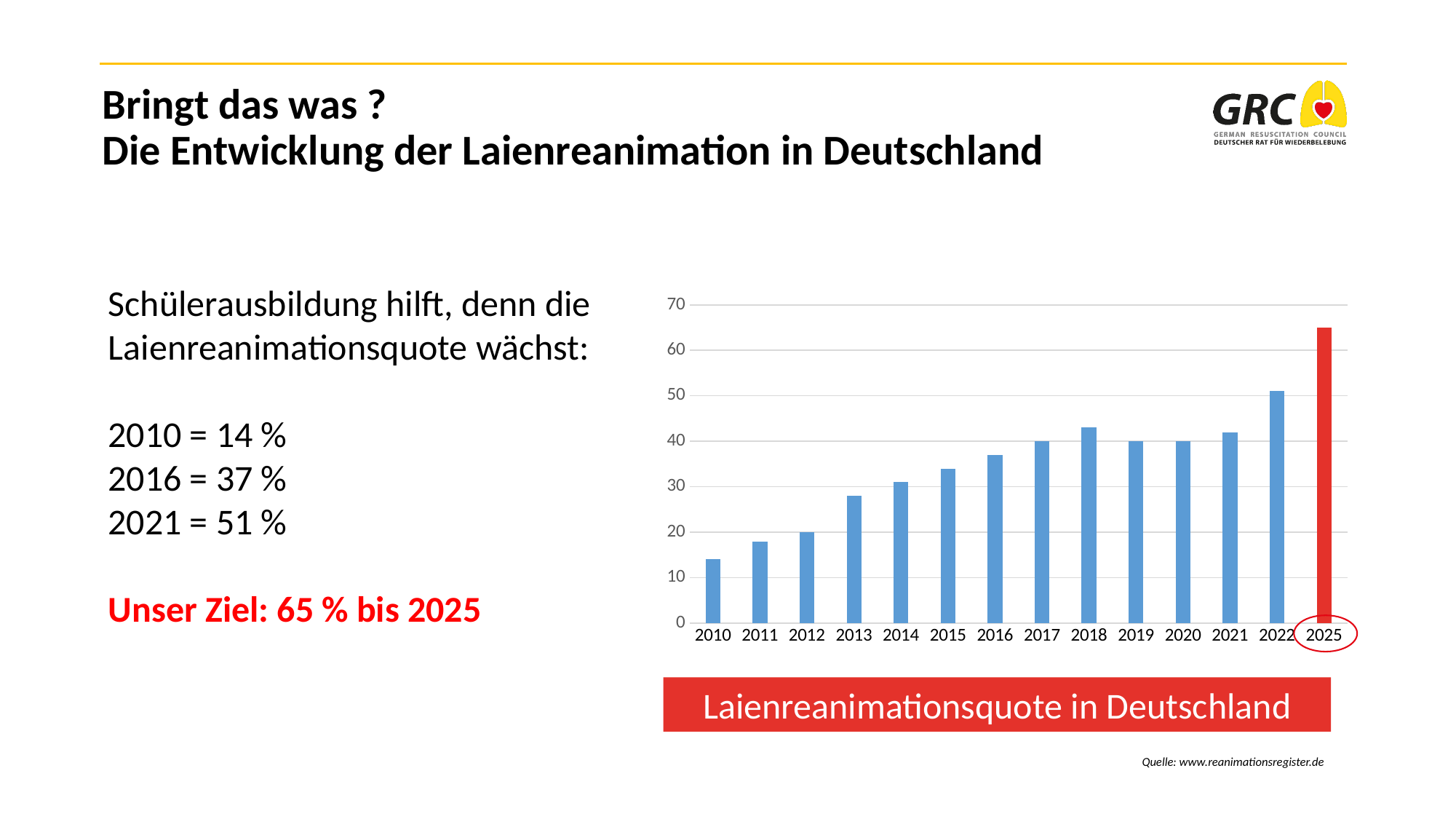
What is the target value shown for 2025? 65 % How many years are shown on the x axis of the chart? 14 What is the Laienreanimationsquote for 2016? 37 % What kind of chart is shown on the slide? bar chart Which year has the lowest bar in the chart? 2010 What is the Laienreanimationsquote for 2010? 14 % What is the title shown below the chart? Laienreanimationsquote in Deutschland Is the value for 2013 greater or less than 30? less By how much did the Laienreanimationsquote increase from 2010 to 2016? 23 % Which bar is higher, 2022 or 2021? 2022 Which year has the highest bar in the chart? 2025